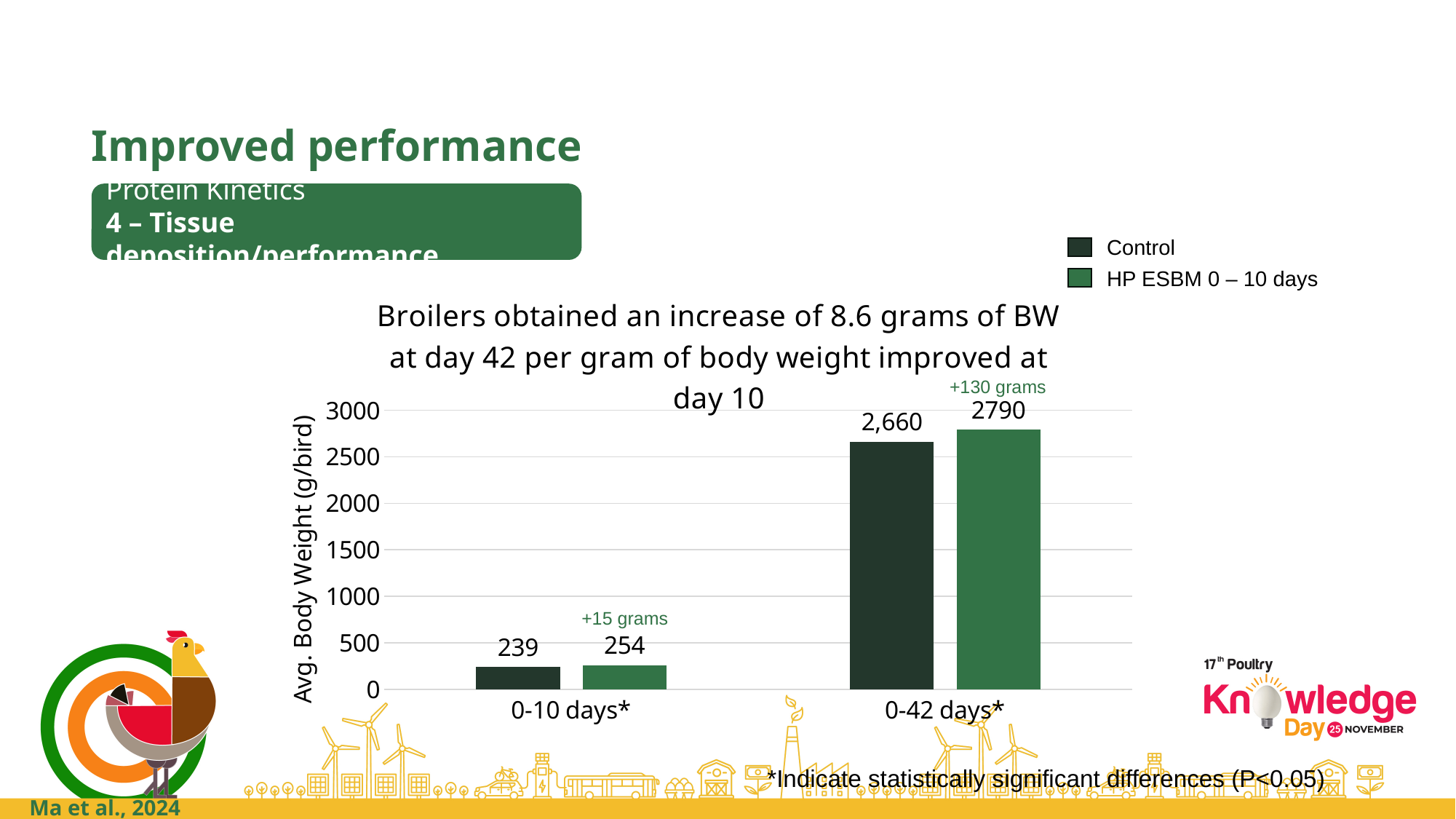
What is the average body weight for the Control group at 0-10 days*? 239 What type of chart is shown on the slide? Bar chart What is the difference between the HP ESBM 0 – 10 days and Control values at 0-10 days*? 15 How many series does the legend list? 2 What is the average body weight for the Control group at 0-42 days*? 2,660 What is the difference between the HP ESBM 0 – 10 days and Control values at 0-42 days*? 130 Which bar has the lowest value on the chart? Control at 0-10 days* What is the average body weight for HP ESBM 0 – 10 days at 0-10 days*? 254 Which is larger at 0-42 days*: Control or HP ESBM 0 – 10 days? HP ESBM 0 – 10 days What is the average body weight for HP ESBM 0 – 10 days at 0-42 days*? 2790 Which bar has the highest value on the chart? HP ESBM 0 – 10 days at 0-42 days* What is the label of the y axis? Avg. Body Weight (g/bird)